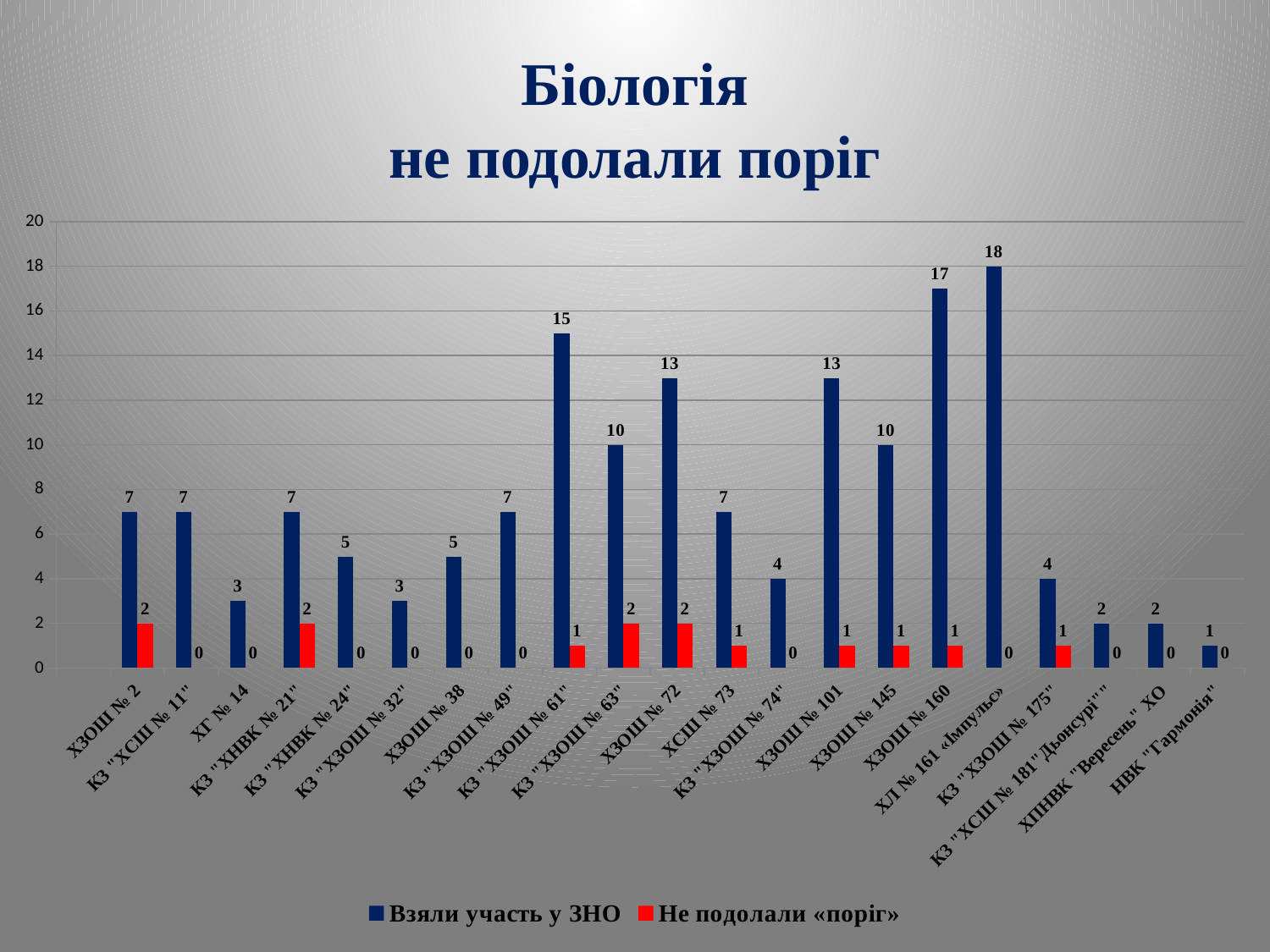
Which school has the highest value for "Взяли участь у ЗНО"? ХЛ № 161 «Імпульс» What is the value of "Взяли участь у ЗНО" for ХЛ № 161 «Імпульс»? 18 How many series does the legend list? 2 How many schools (categories) are shown on the x axis? 21 What is the title of the chart? Біологія не подолали поріг Is the value of "Взяли участь у ЗНО" for ХЗОШ № 101 greater or less than 10? greater Which is larger: "Взяли участь у ЗНО" for КЗ "ХЗОШ № 61" or for ХЗОШ № 72? КЗ "ХЗОШ № 61" What is the value of "Не подолали «поріг»" for КЗ "ХЗОШ № 63"? 2 What type of chart is shown on the slide? bar chart What is the value of "Взяли участь у ЗНО" for КЗ "ХНВК № 24"? 5 What is the difference between "Взяли участь у ЗНО" and "Не подолали «поріг»" for ХЗОШ № 160? 16 Which school has the lowest value for "Взяли участь у ЗНО"? НВК "Гармонія"